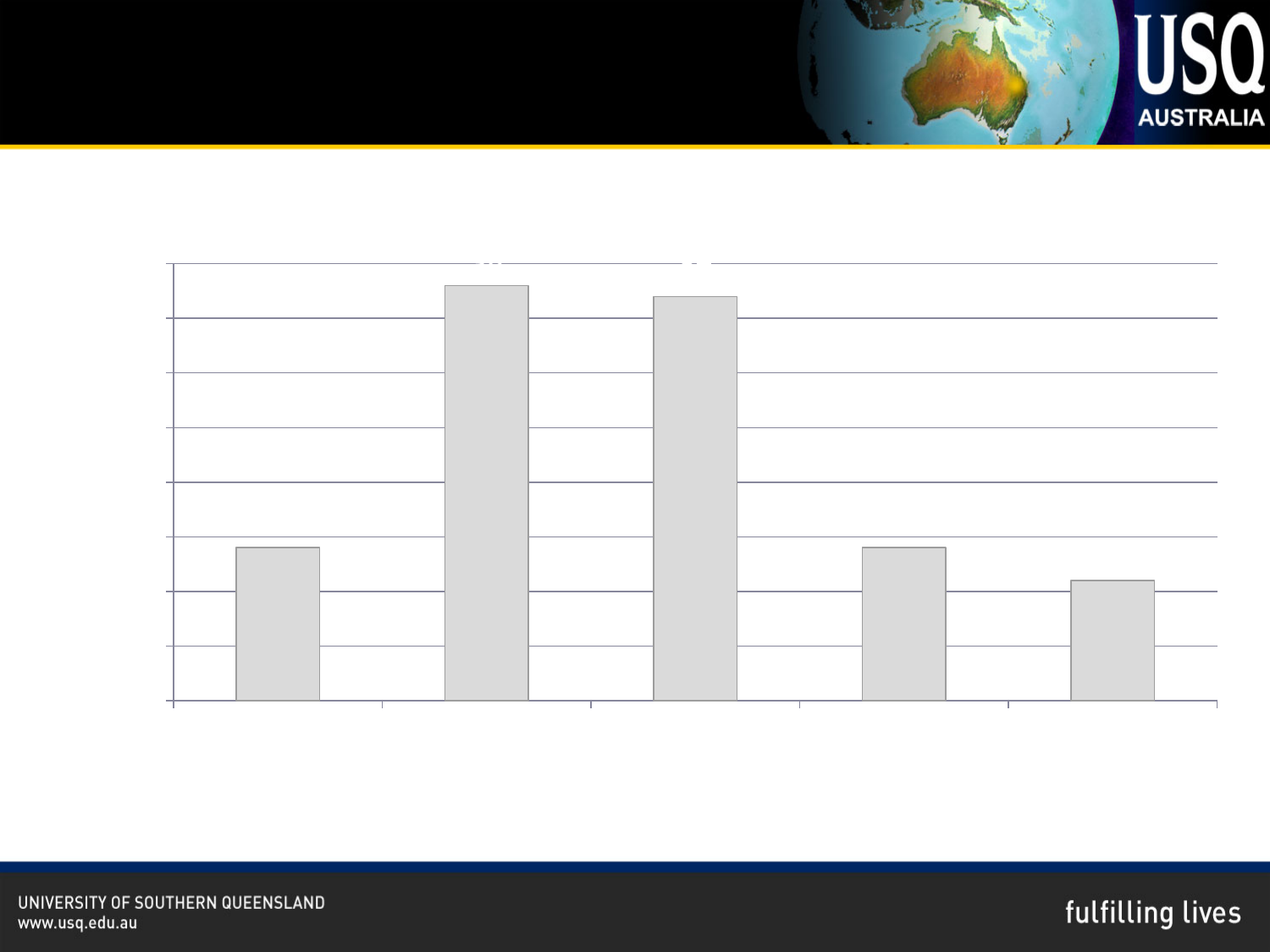
Which bar in the chart is the shortest, counting from the left? the fifth bar What colour are the bars in the chart? light grey What kind of chart is shown on the slide? bar chart Is the second bar from the left taller or shorter than the third bar from the left? taller How many horizontal gridlines are drawn above the x axis in the chart? 8 Is the fourth bar from the left taller or shorter than the third bar from the left? shorter Is the first bar from the left taller or shorter than the fifth bar from the left? taller Which bar in the chart is the tallest, counting from the left? the second bar How many bars are plotted in the chart? 5